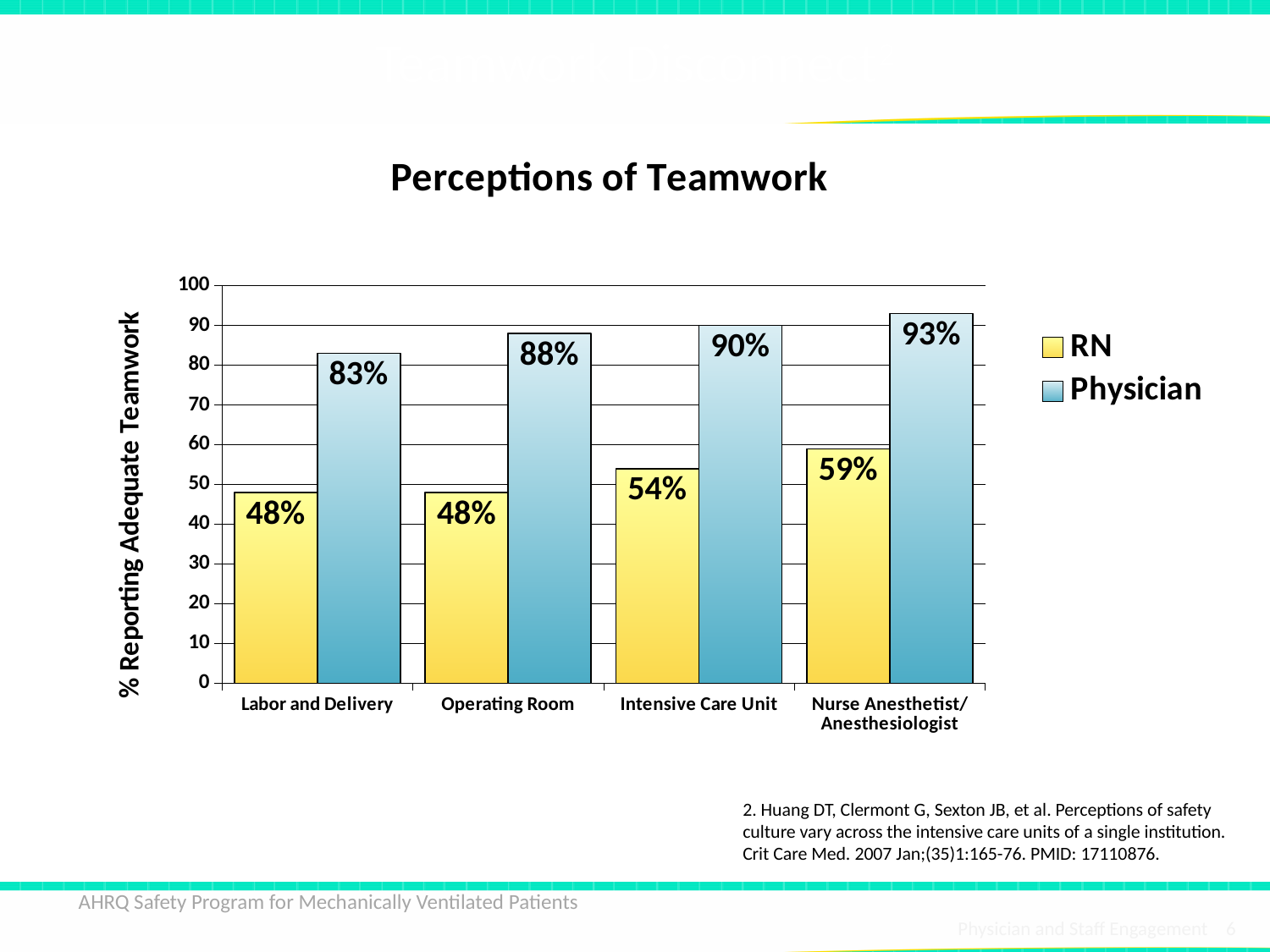
What is the RN value for Nurse Anesthetist/Anesthesiologist? 59% What is the difference between the Physician and RN values for Labor and Delivery? 35% How many series does the legend list? 2 What is the title of the chart? Perceptions of Teamwork Which is larger in the Intensive Care Unit, the RN value or the Physician value? Physician What percentage of RNs reported adequate teamwork in the Operating Room? 48% Which category has the lowest Physician value? Labor and Delivery Which category has the highest Physician value? Nurse Anesthetist/Anesthesiologist What percentage of Physicians reported adequate teamwork in the Intensive Care Unit? 90% How many categories are shown on the x axis? 4 Is the Physician value for the Operating Room greater or less than 80? greater What kind of chart is shown on the slide? Bar chart